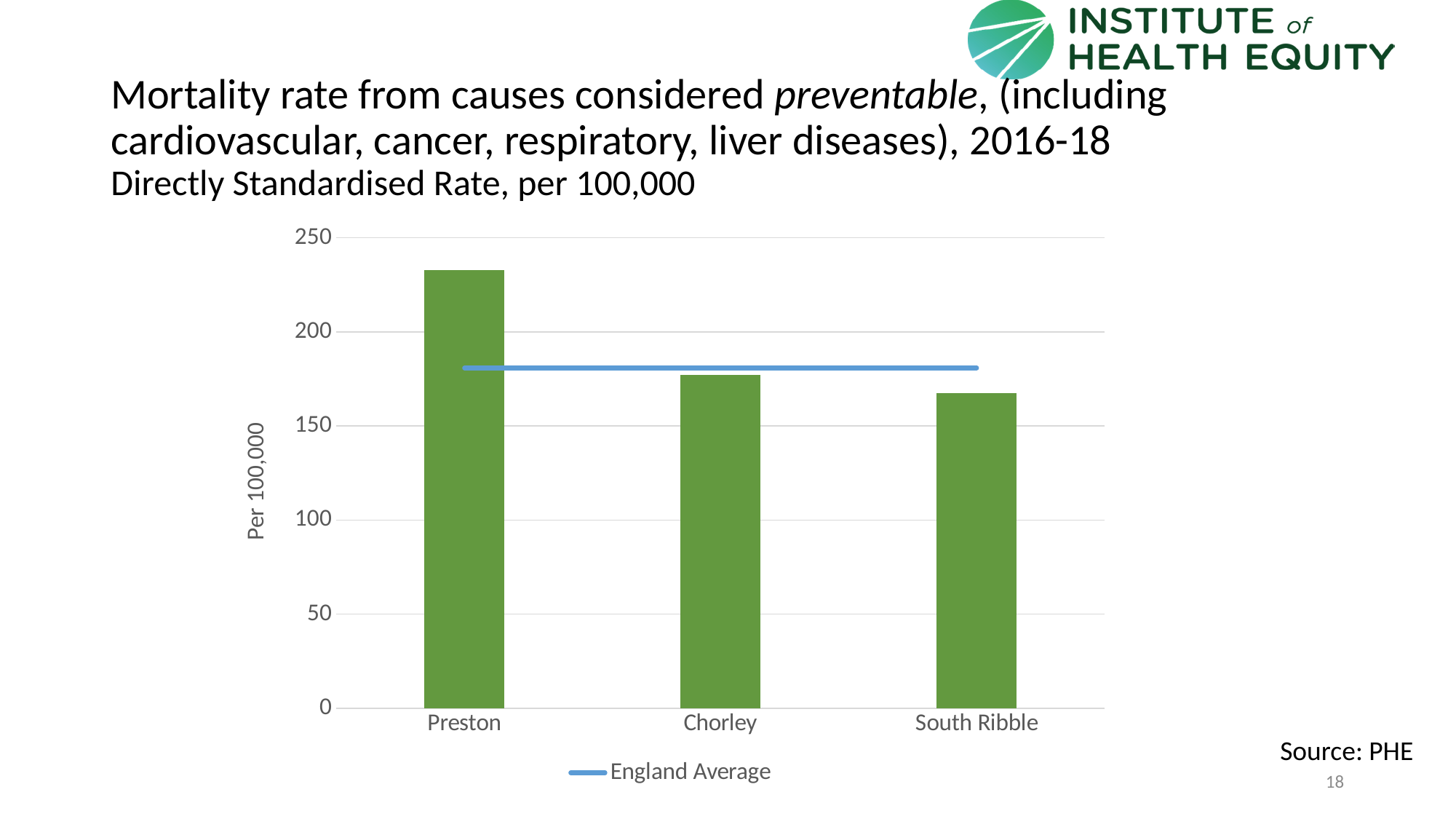
Which area has the highest preventable mortality rate? Preston How many entries does the legend list? 1 What is the label on the vertical axis? Per 100,000 Which area has the lowest preventable mortality rate? South Ribble Is the value for Preston greater or less than 200? greater Is the value for South Ribble greater or less than 150? greater Is the value for South Ribble above or below the England Average line? below How many areas (bars) are plotted on the chart? 3 What kind of chart is shown on the slide? Combination bar and line chart (bars with an England Average line) Do the bar values rise or fall from Preston to South Ribble along the x axis? fall Is the value for Chorley greater or less than 200? less Which has the higher preventable mortality rate, Chorley or South Ribble? Chorley